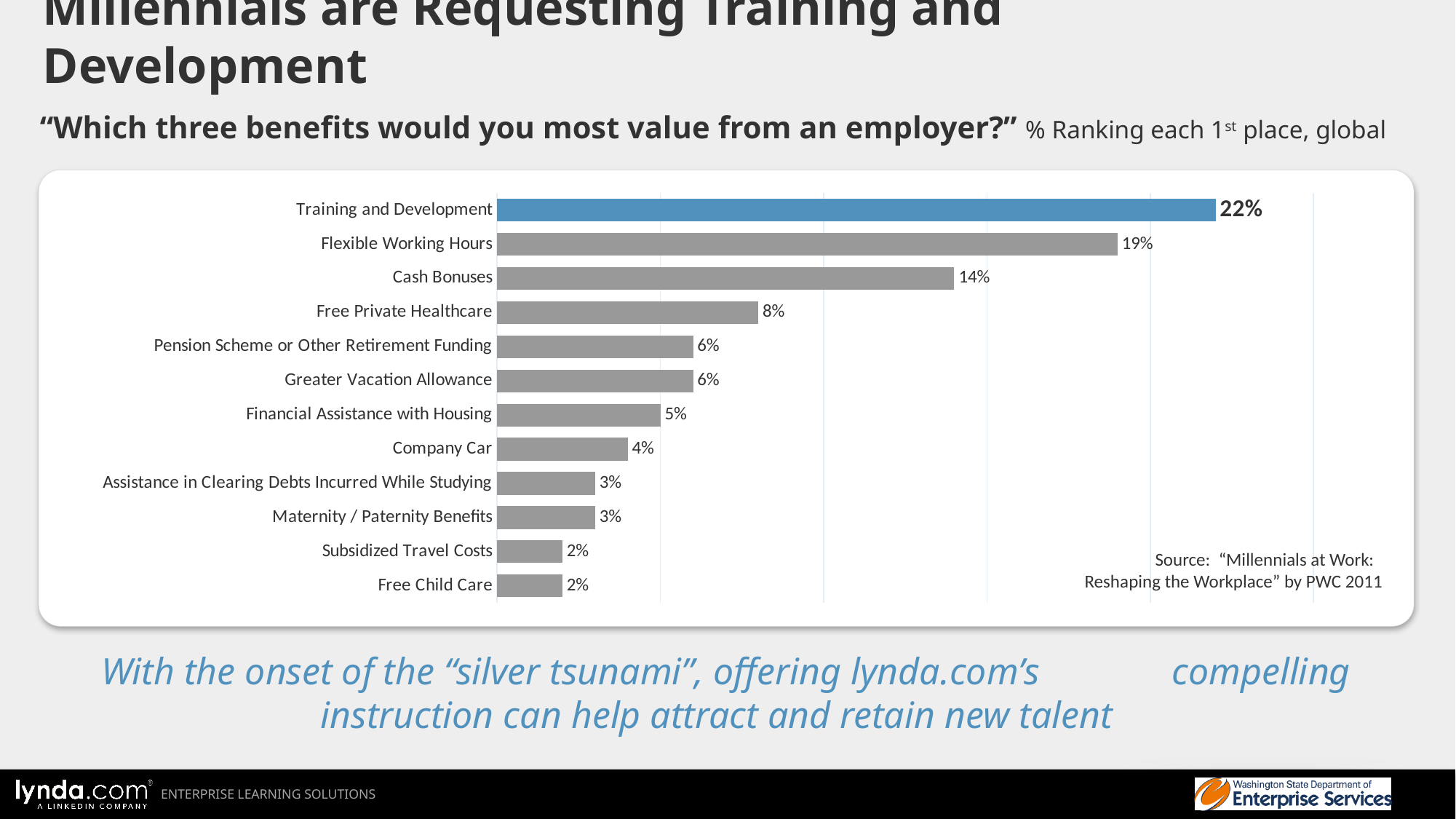
What is the value shown for Flexible Working Hours? 19% Which bar in the chart is coloured blue rather than grey? Training and Development Which benefit has the highest percentage in the chart? Training and Development What is the value shown for Cash Bonuses? 14% Which has a larger value, Free Private Healthcare or Financial Assistance with Housing? Free Private Healthcare What is the value shown for Company Car? 4% What kind of chart is shown on the slide? Bar chart What is the difference between the values for Training and Development and Flexible Working Hours? 3% What is the difference between the values for Cash Bonuses and Free Private Healthcare? 6% How many benefit categories are shown in the chart? 12 What is the value shown for Subsidized Travel Costs? 2% What percentage of respondents ranked Training and Development as their first-place benefit? 22%